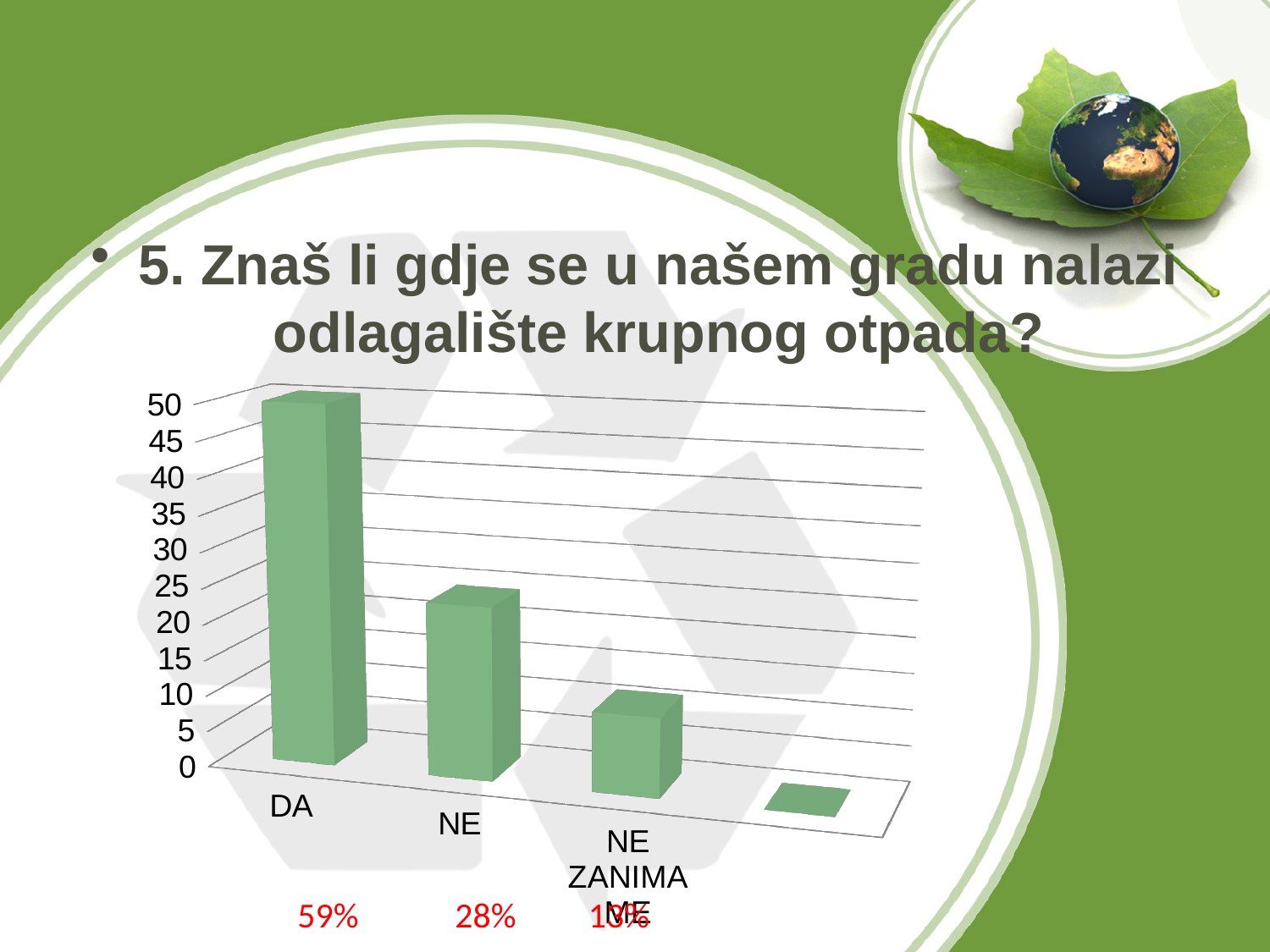
Is the value for NE greater or less than 30? less What percentage is printed in red below the DA bar? 59% Which bar is taller, DA or NE? DA Which bar is taller, NE or NE ZANIMA ME? NE What kind of chart is shown on the slide? bar chart Which category has the highest bar? DA Is the value for NE greater or less than 15? greater Which of the labeled categories has the lowest bar? NE ZANIMA ME Is the value for NE ZANIMA ME greater or less than 15? less Do the bar heights rise or fall from left to right across the categories? fall What is the highest value shown on the vertical axis? 50